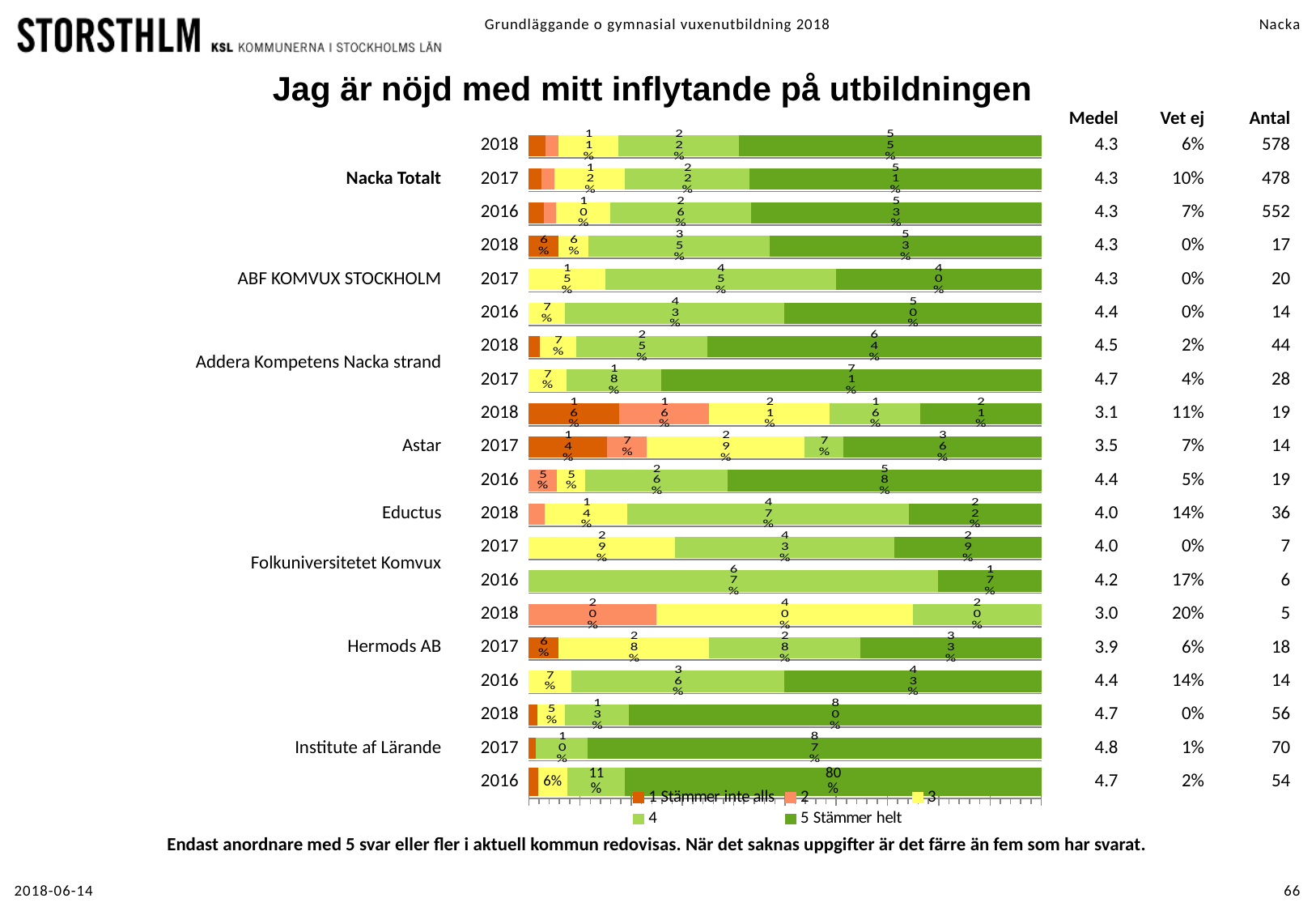
What is the '4' share for Folkuniversitetet Komvux in 2016? 67% Which of the two is larger: the '5 Stämmer helt' share for Addera Kompetens Nacka strand in 2017 or in 2018? 2017 What is the '5 Stämmer helt' share for Institute af Lärande in 2017? 87% What is the '5 Stämmer helt' share for Nacka Totalt in 2018? 55% What is the difference between the '5 Stämmer helt' share for Institute af Lärande in 2018 and for Hermods AB in 2018? 80 percentage points What is the '1 Stämmer inte alls' share for Astar in 2018? 16% What kind of chart is shown on the slide? stacked bar chart How many bars are plotted in the chart? 20 What is the Antal value for Nacka Totalt in 2018? 578 What is the Medel value for Institute af Lärande in 2017? 4.8 What is the title of the chart? Jag är nöjd med mitt inflytande på utbildningen How many series does the legend list? 5